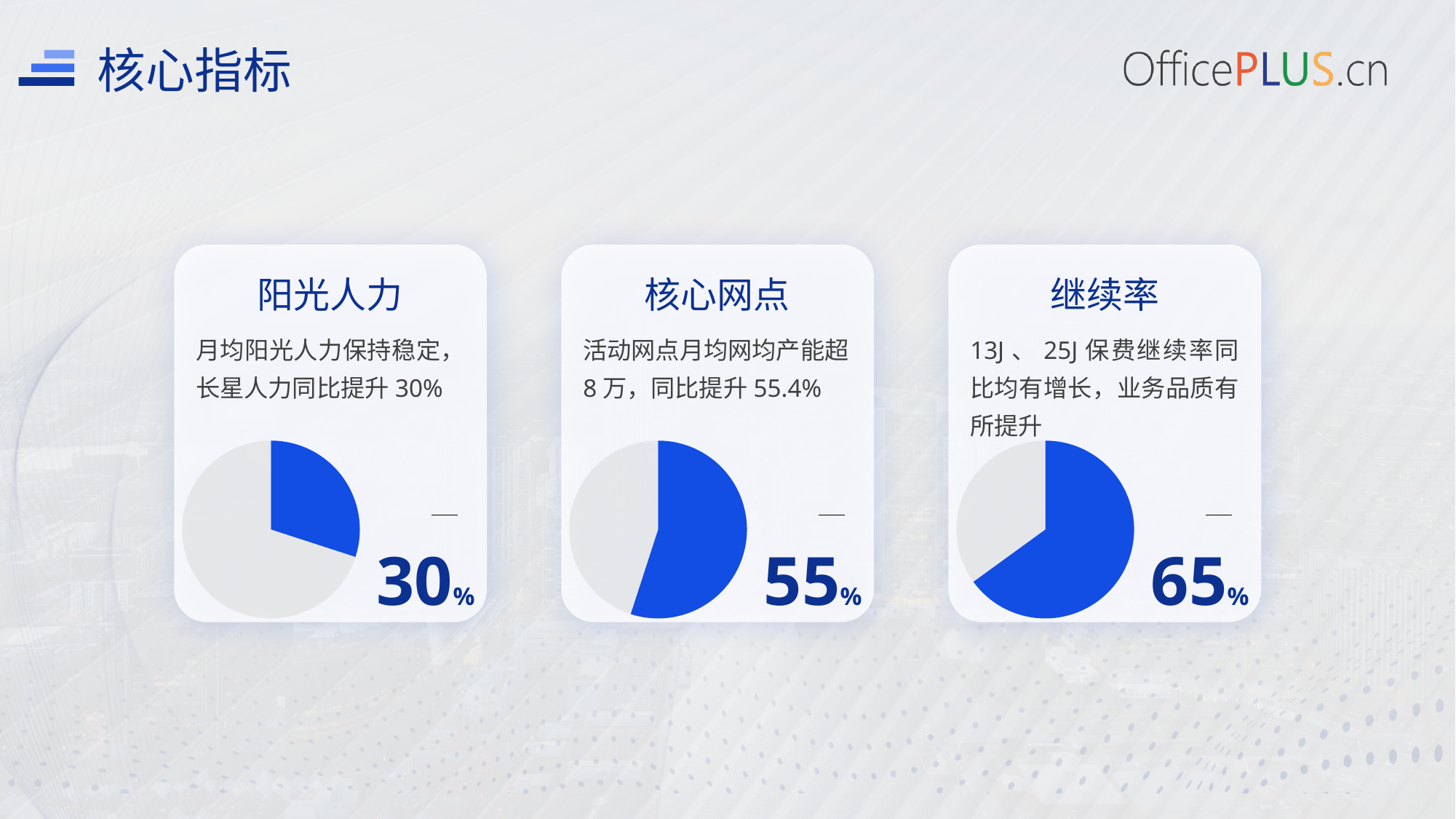
In the 阳光人力 pie chart, what share does the blue slice represent? 30% In the 核心网点 pie chart, what share does the blue slice represent? 55% What is the difference in percentage points between the blue slice of the 继续率 pie chart and the blue slice of the 核心网点 pie chart? 10 What is the difference in percentage points between the blue slice of the 继续率 pie chart and the blue slice of the 阳光人力 pie chart? 35 Is the blue slice in the 核心网点 pie chart larger or smaller than the blue slice in the 阳光人力 pie chart? larger How many slices does each pie chart on the slide have? 2 What kind of chart is shown in the 阳光人力 card? pie chart What colour is the highlighted slice in each pie chart on the slide? blue Which of the three pie charts on the slide has the smallest blue slice? 阳光人力 How many pie charts are shown on the slide? 3 Which of the three pie charts on the slide has the largest blue slice? 继续率 In the 继续率 pie chart, what share does the blue slice represent? 65%